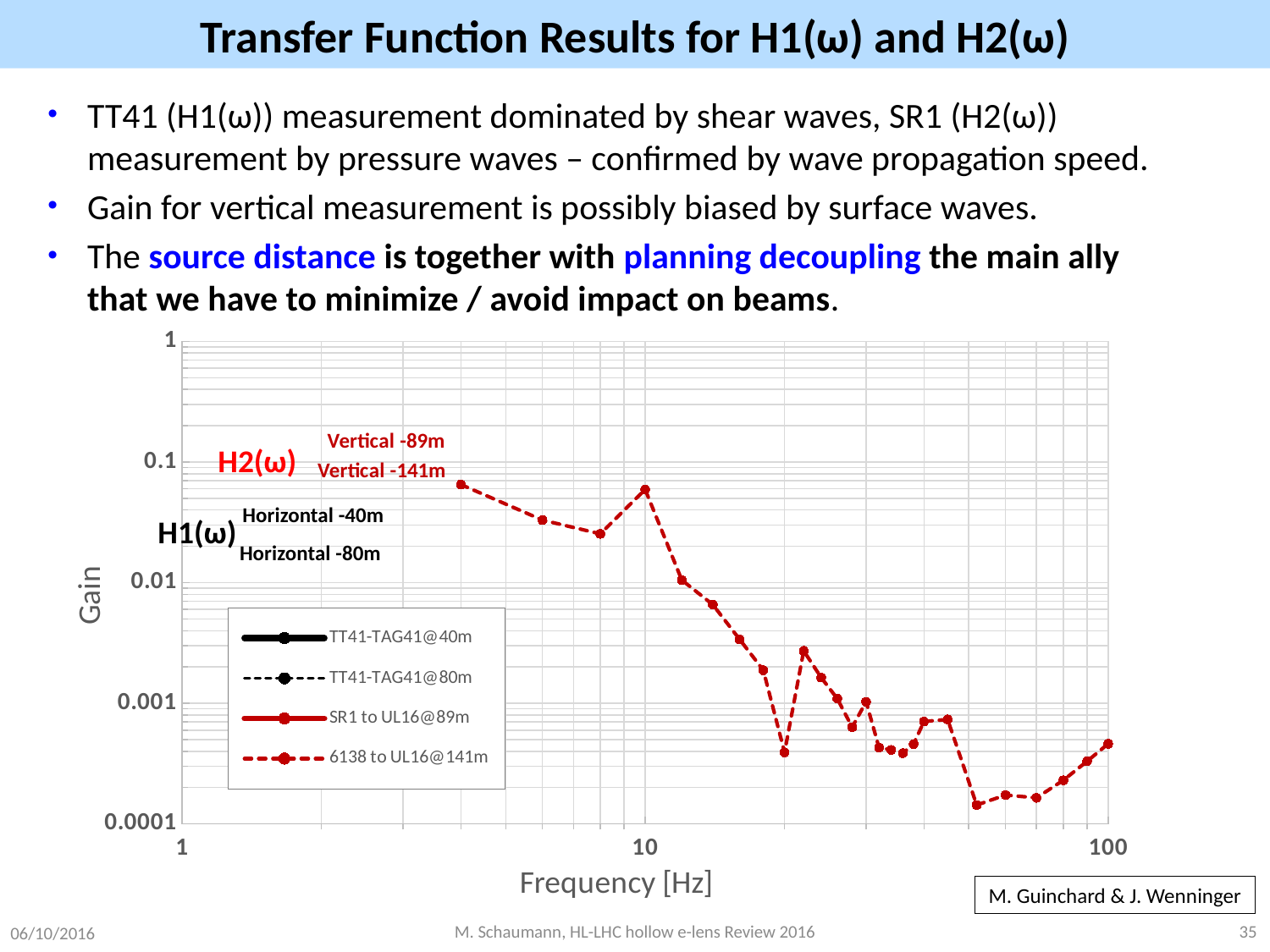
Is the plotted gain at 10 Hz greater or less than 0.1? less Is the plotted gain at 100 Hz greater or less than 0.0001? greater How many series does the chart legend list? 4 What is the lowest value shown on the Gain axis? 0.0001 Is the plotted gain at 10 Hz greater or less than 0.01? greater What is the label of the x axis of the chart? Frequency [Hz] Which is larger, the plotted gain at 10 Hz or the plotted gain at 100 Hz? 10 Hz Which legend entry is drawn with a solid black line? TT41-TAG41@40m What is the highest value shown on the Gain axis? 1 What kind of chart is shown on the slide? line chart Overall, does the plotted gain rise or fall as frequency increases from 1 Hz to 100 Hz? fall